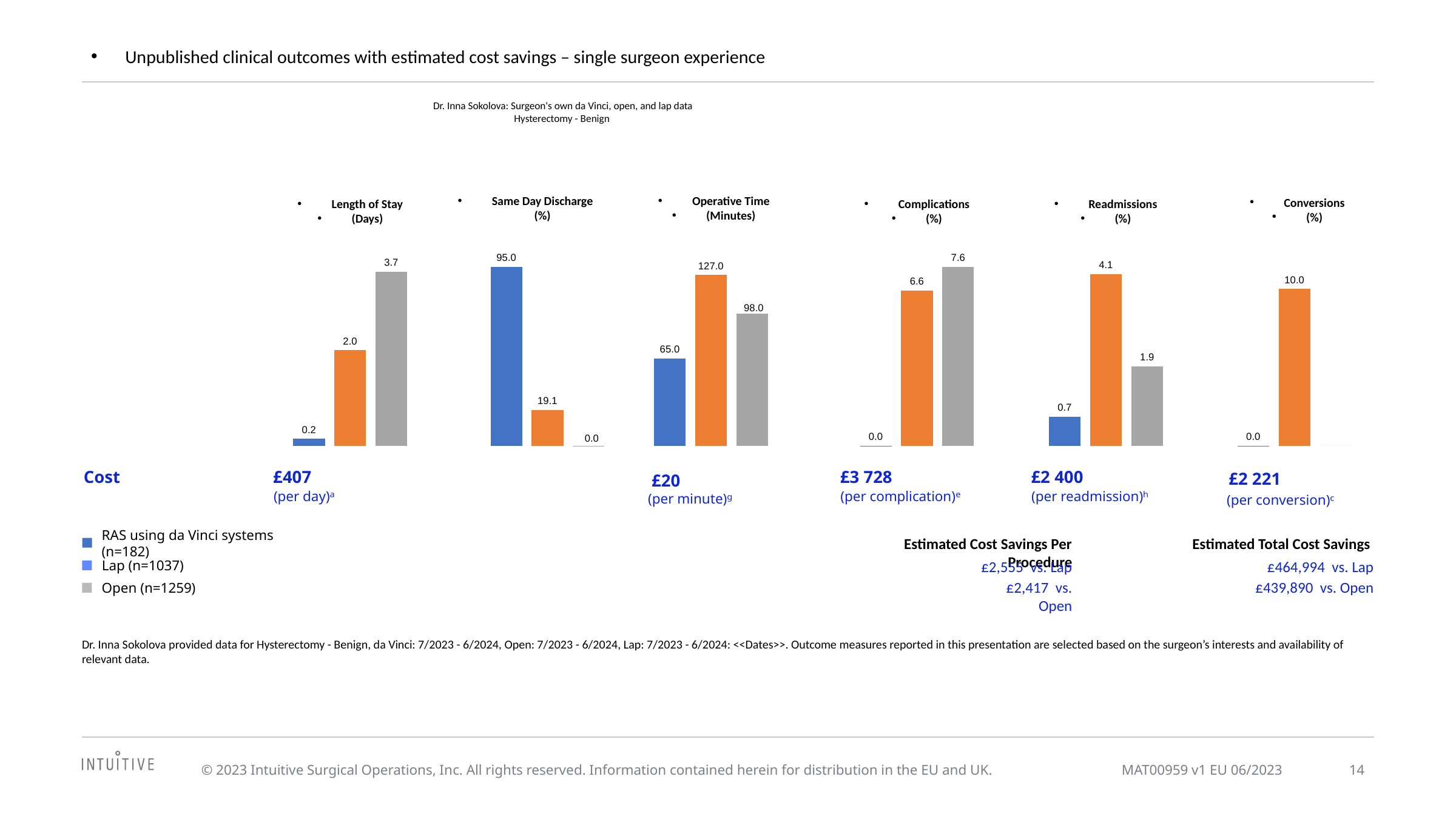
How many series does the legend list? 3 In the Same Day Discharge (%) chart, what is the value for Lap? 19.1 In the Same Day Discharge (%) chart, which series has the highest value? RAS using da Vinci systems In the Readmissions (%) chart, which is larger, the Lap value or the Open value? Lap In the Length of Stay (Days) chart, what is the value for RAS using da Vinci systems? 0.2 In the Length of Stay (Days) chart, what is the value for Open? 3.7 In the Operative Time (Minutes) chart, which series has the lowest value? RAS using da Vinci systems In the Operative Time (Minutes) chart, what is the difference between the Lap value and the RAS using da Vinci systems value? 62.0 In the Conversions (%) chart, what is the value for Lap? 10.0 In the Readmissions (%) chart, what is the value for RAS using da Vinci systems? 0.7 What kind of chart is the Operative Time (Minutes) chart? Bar chart In the Complications (%) chart, what is the value for Open? 7.6